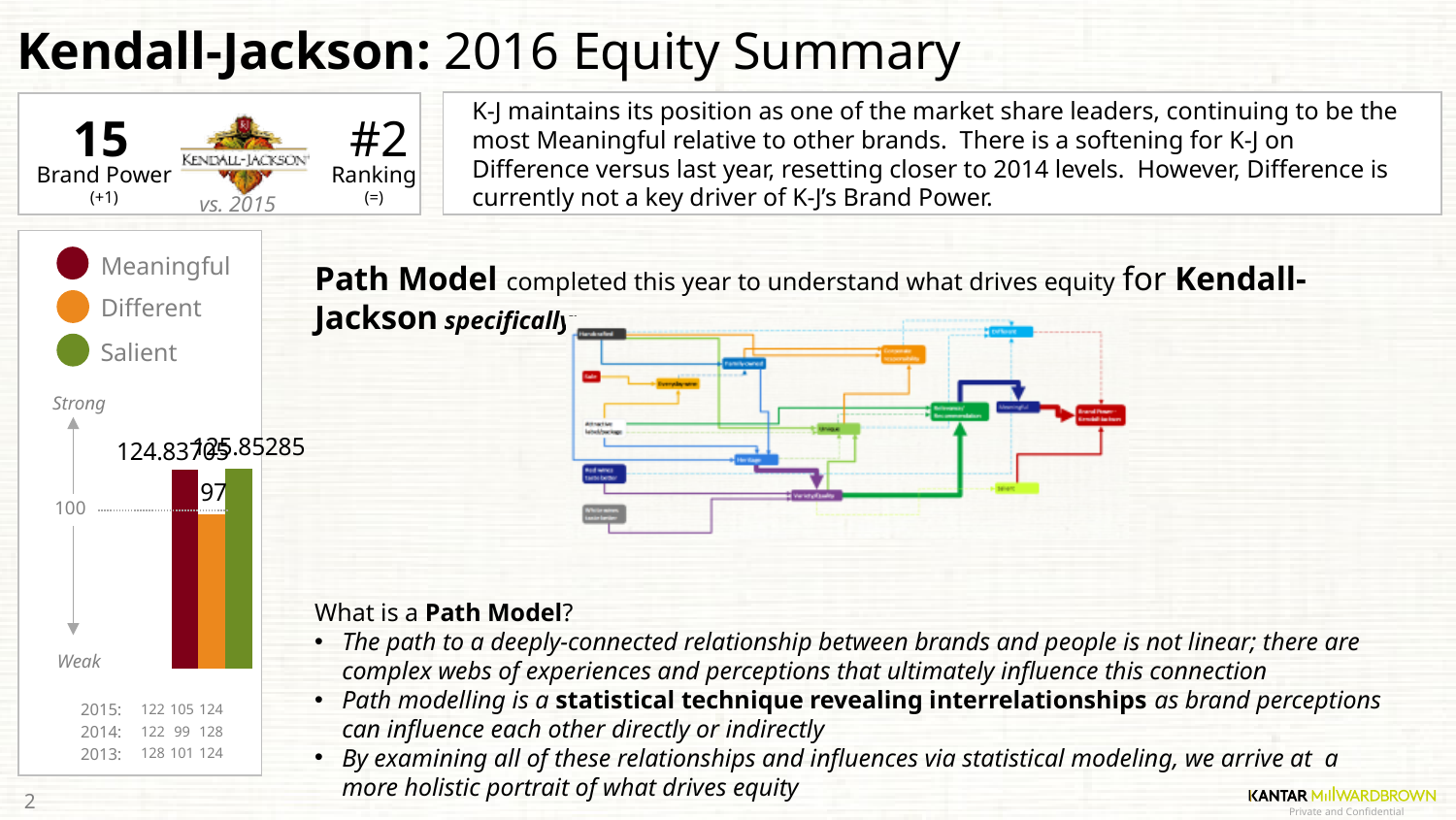
According to the figures listed under the bar chart, what was the Different value in 2015? 105 Is the value for Different in the bar chart greater or less than 100? less Is the value for Meaningful in the bar chart greater or less than 100? greater How many series does the legend of the bar chart list? 3 What kind of chart is shown on the left of the slide? bar chart Which category has the lowest bar in the bar chart? Different How many bars are plotted in the bar chart? 3 What labels mark the top and bottom of the vertical axis in the bar chart? Strong and Weak Which is larger in the bar chart, Meaningful or Different? Meaningful Is the value for Salient in the bar chart greater or less than 100? greater What colour represents Salient in the bar chart legend? green What is the value shown for Different in the bar chart? 97